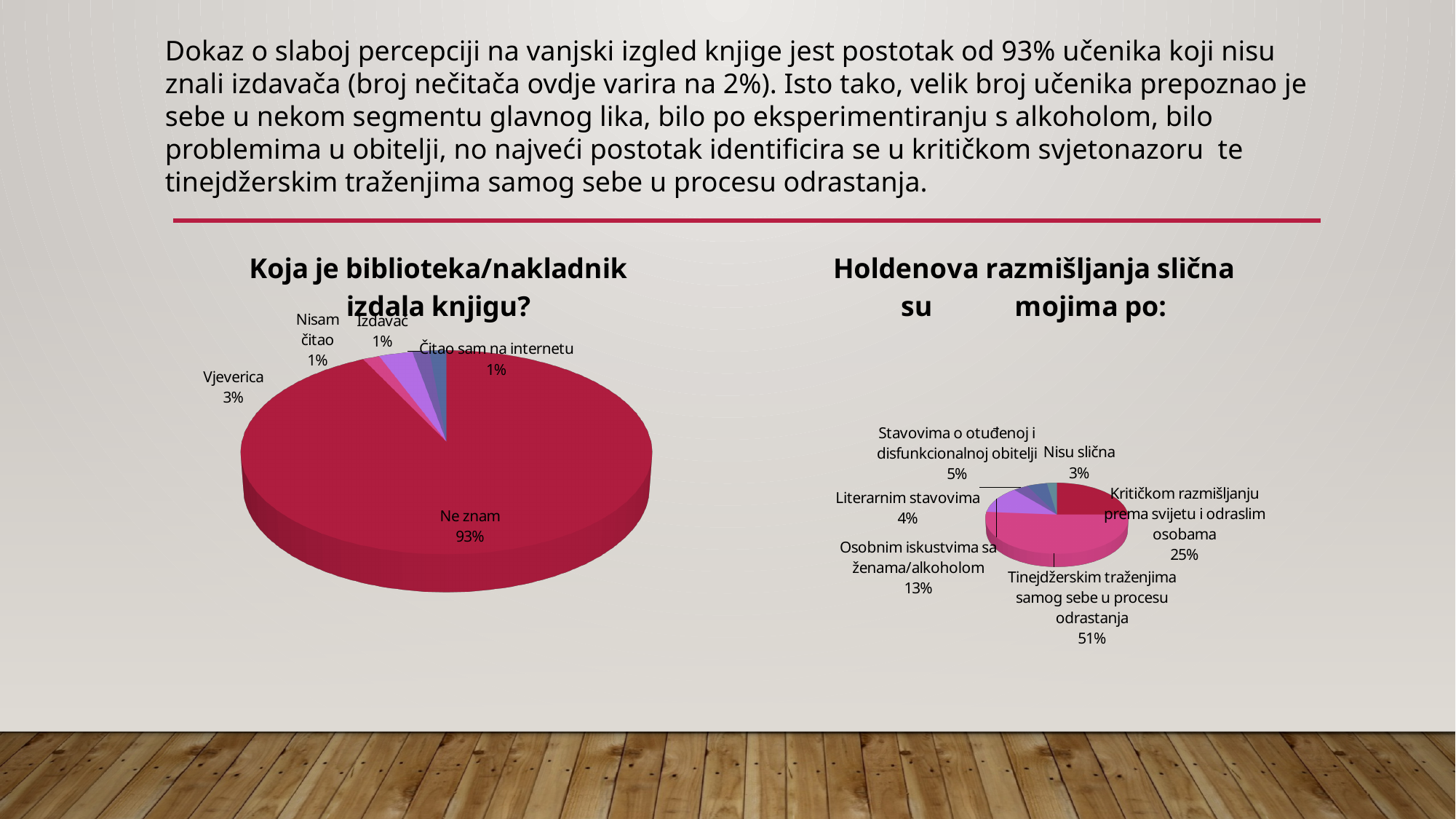
What is the title of the chart on the right of the slide? Holdenova razmišljanja slična su mojima po: In the chart titled "Holdenova razmišljanja slična su mojima po:", which category has the smallest slice? Nisu slična In the chart titled "Holdenova razmišljanja slična su mojima po:", what is the value for "Osobnim iskustvima sa ženama/alkoholom"? 13% In the chart titled "Holdenova razmišljanja slična su mojima po:", what is the difference between "Tinejdžerskim traženjima samog sebe u procesu odrastanja" and "Kritičkom razmišljanju prema svijetu i odraslim osobama"? 26% In the chart titled "Koja je biblioteka/nakladnik izdala knjigu?", which category has the largest slice? Ne znam In the chart titled "Holdenova razmišljanja slična su mojima po:", how many categories are shown? 6 In the chart titled "Koja je biblioteka/nakladnik izdala knjigu?", how many slices does the pie have? 5 In the chart titled "Holdenova razmišljanja slična su mojima po:", which is larger: "Stavovima o otuđenoj i disfunkcionalnoj obitelji" or "Literarnim stavovima"? Stavovima o otuđenoj i disfunkcionalnoj obitelji In the chart titled "Koja je biblioteka/nakladnik izdala knjigu?", what share of the pie is "Ne znam"? 93% In the chart titled "Holdenova razmišljanja slična su mojima po:", what is the value for "Tinejdžerskim traženjima samog sebe u procesu odrastanja"? 51% In the chart titled "Koja je biblioteka/nakladnik izdala knjigu?", what is the value for "Vjeverica"? 3% What kind of chart is the one on the left of the slide? Pie chart